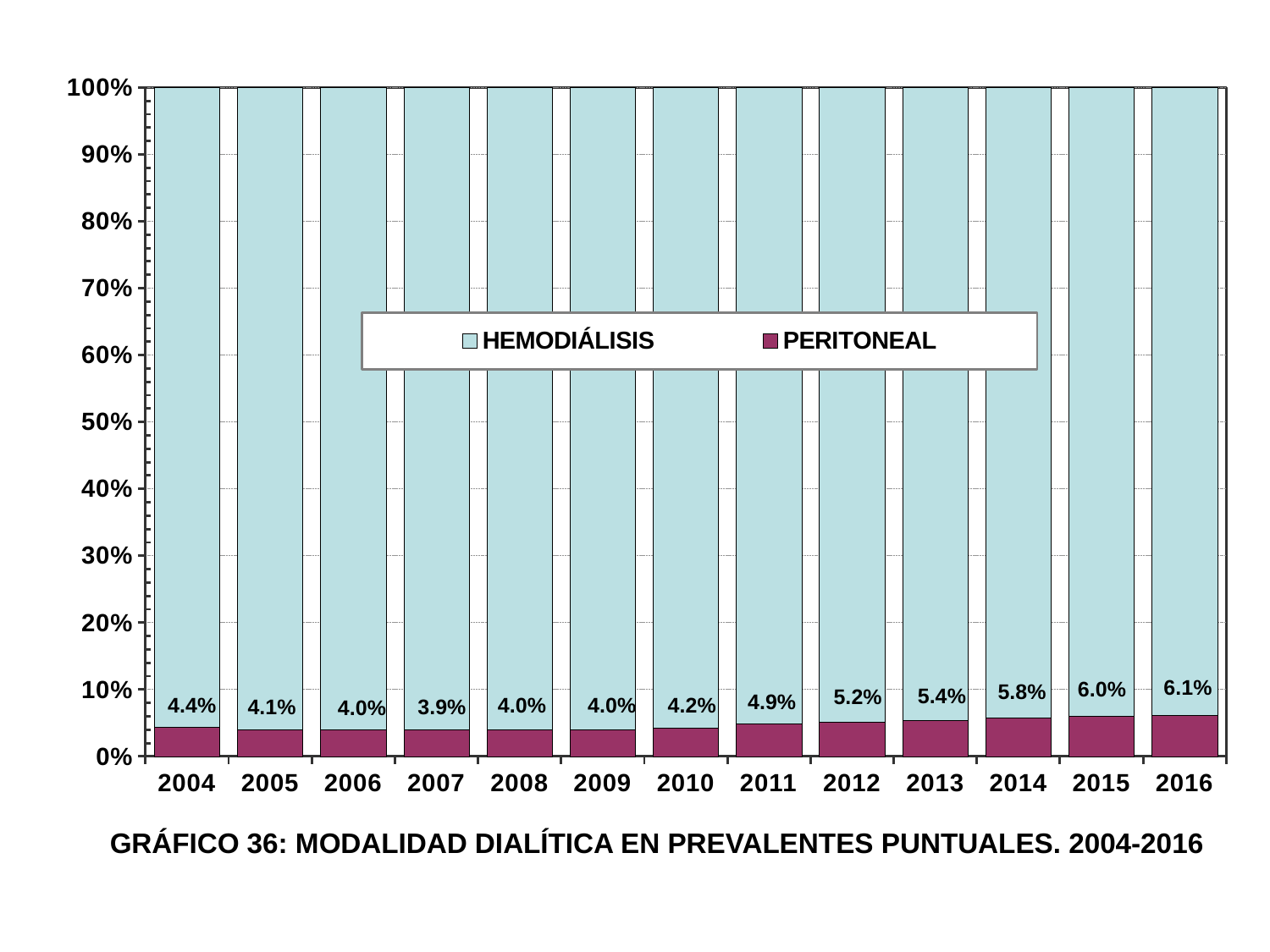
What is the PERITONEAL value for 2016? 6.1% Which year has the lowest PERITONEAL value? 2007 Which year has the highest PERITONEAL value? 2016 What kind of chart is shown on the slide? Stacked bar chart What is the PERITONEAL value for 2011? 4.9% What is the PERITONEAL value for 2007? 3.9% How many series does the legend list? 2 Is the HEMODIÁLISIS value for 2016 greater or less than 90%? greater Do the PERITONEAL values rise or fall from 2010 to 2016? Rise How many years are shown on the x axis? 13 What is the difference between the PERITONEAL values for 2016 and 2004? 1.7% Which is larger, the PERITONEAL value for 2012 or for 2010? 2012